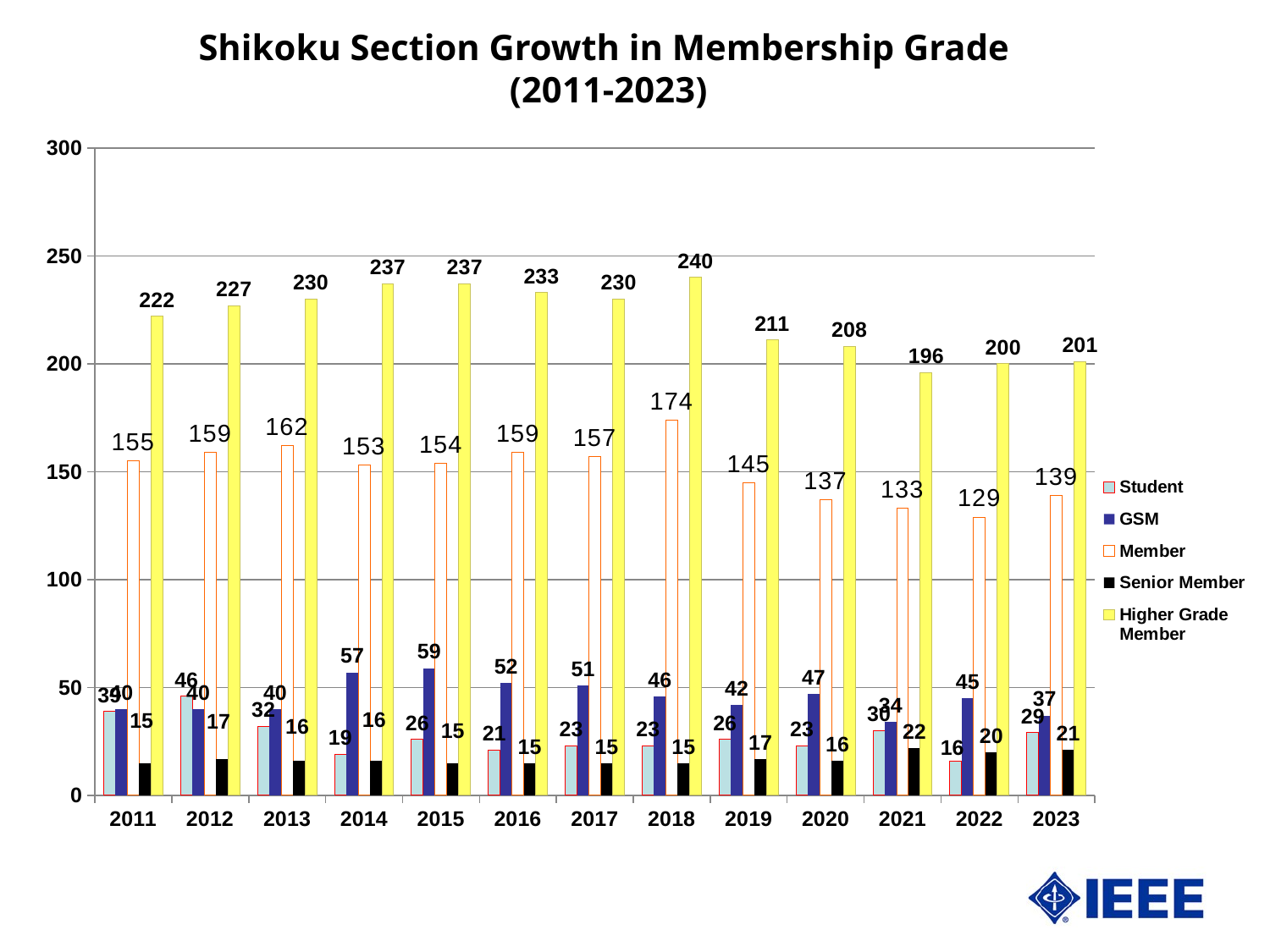
In which year is the Student value lowest? 2022 What is the value for Senior Member in 2021? 22 How many years are shown on the x axis? 13 What is the value for Member in 2022? 129 Does the Higher Grade Member value rise or fall from 2018 to 2021? Fall In which year is the Higher Grade Member value highest? 2018 What kind of chart is shown on the slide? Bar chart What is the difference between the Member values in 2018 and 2022? 45 Which is larger, the GSM value in 2014 or the GSM value in 2019? 2014 What is the value for GSM in 2015? 59 What is the value for Higher Grade Member in 2018? 240 How many series does the legend list? 5